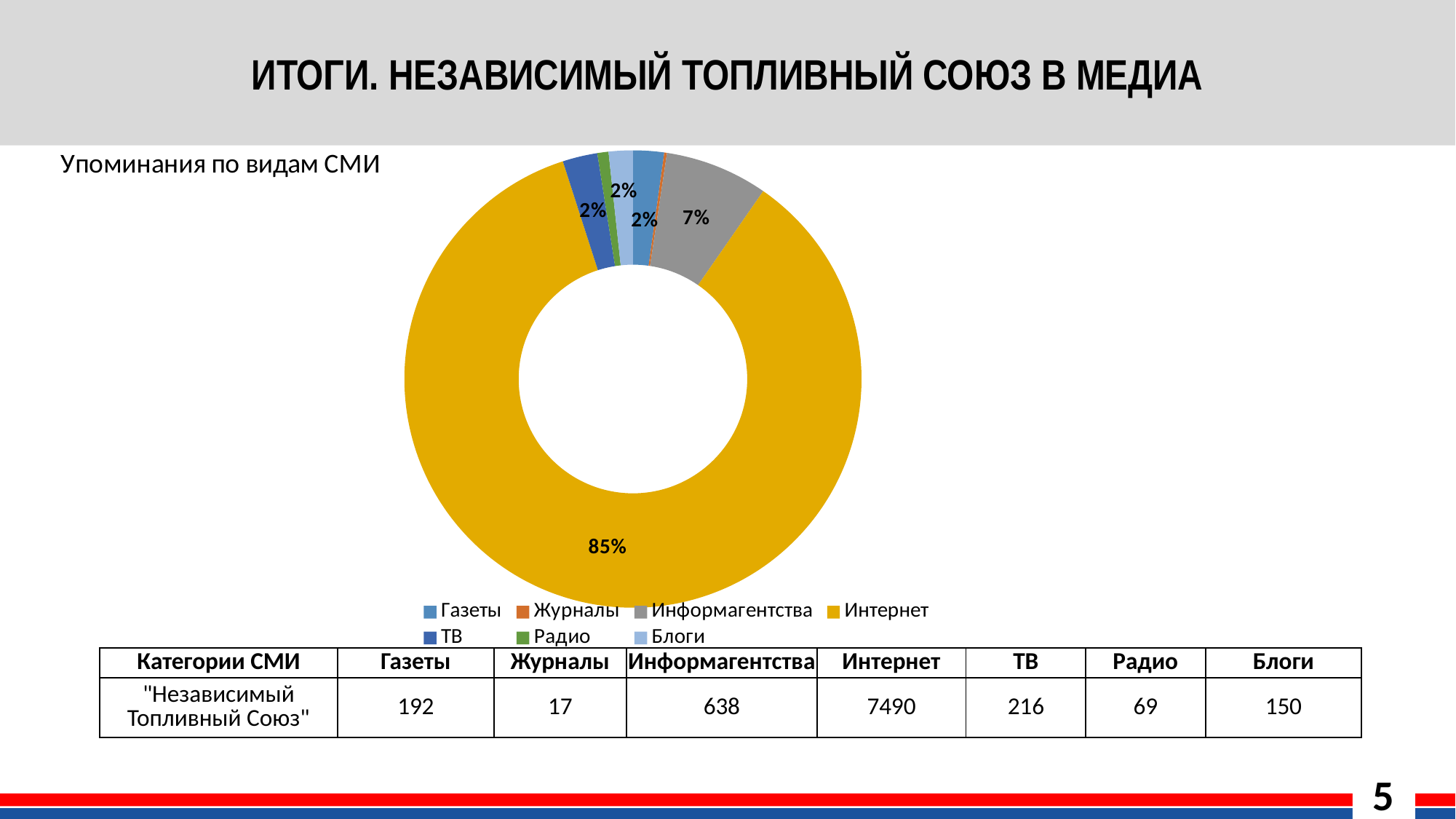
How many categories does the legend of the doughnut chart list? 7 What is the title of the doughnut chart? Упоминания по видам СМИ Which slice is larger in the doughnut chart, Информагентства or Газеты? Информагентства What kind of chart is shown on the slide? Doughnut (pie) chart Which category has the smallest slice in the doughnut chart? Журналы What share of the doughnut chart does Интернет account for? 85% What share of the doughnut chart does Газеты account for? 2% What is the difference in percentage points between the Интернет slice and the Информагентства slice? 78% Which category has the largest slice in the doughnut chart? Интернет What colour is the Интернет slice in the doughnut chart? Yellow (gold) According to the table under the chart, how many mentions does Интернет have? 7490 What share of the doughnut chart does Информагентства account for? 7%